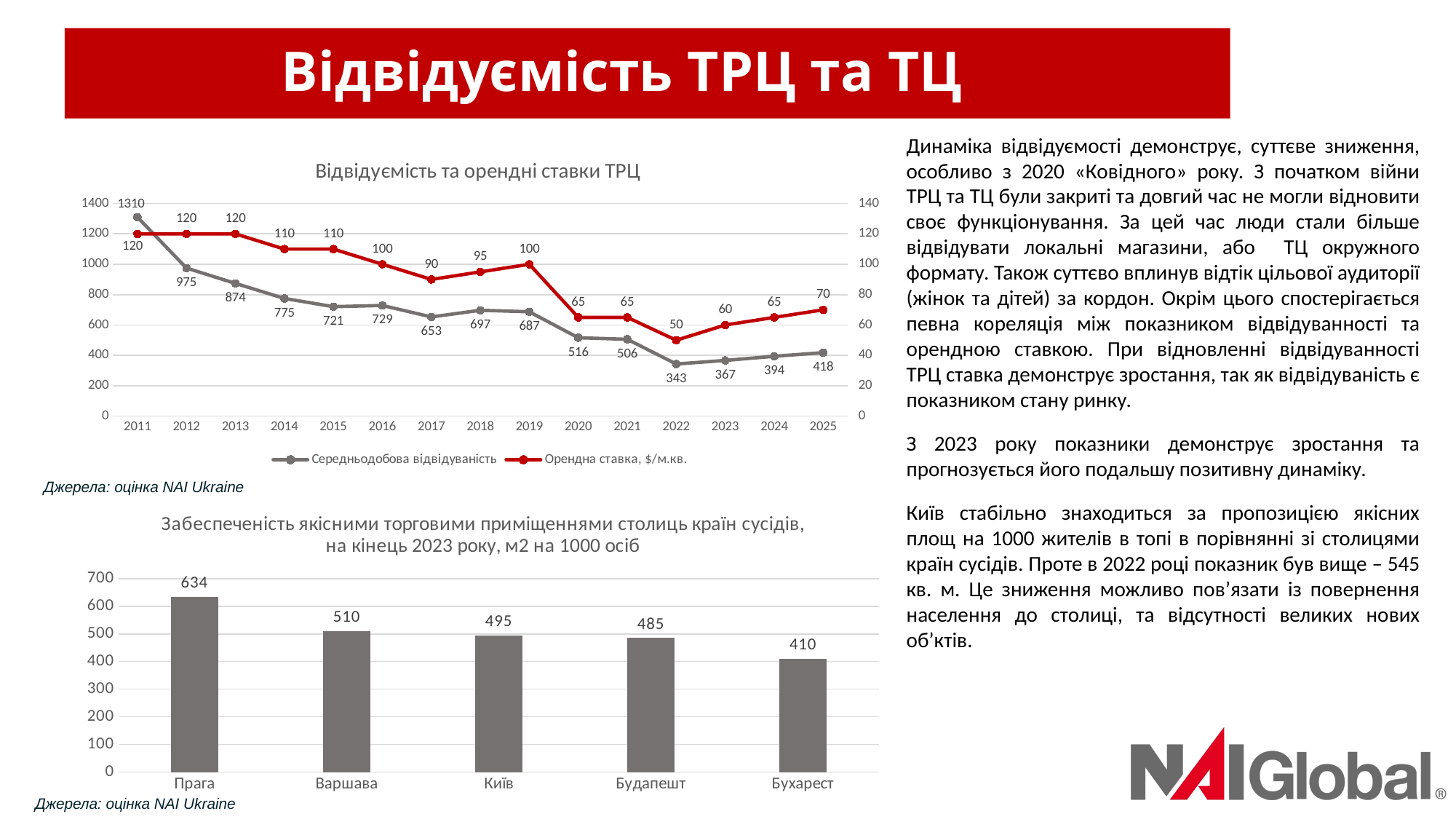
What kind of chart is the bottom chart 'Забезпеченість якісними торговими приміщеннями столиць країн сусідів'? bar chart In the top chart 'Відвідуємість та орендні ставки ТРЦ', what is the Орендна ставка, $/м.кв. in 2022? 50 In the top chart 'Відвідуємість та орендні ставки ТРЦ', what is the difference between Середньодобова відвідуваність in 2011 and in 2012? 335 In the top chart 'Відвідуємість та орендні ставки ТРЦ', does Середньодобова відвідуваність rise or fall from 2011 to 2022? fall In the top chart 'Відвідуємість та орендні ставки ТРЦ', how many series does the legend list? 2 In the top chart 'Відвідуємість та орендні ставки ТРЦ', how many years are shown on the x axis? 15 In the bottom chart 'Забезпеченість якісними торговими приміщеннями столиць країн сусідів', what is the difference between Прага and Варшава? 124 In the top chart 'Відвідуємість та орендні ставки ТРЦ', in which year is Середньодобова відвідуваність lowest? 2022 In the bottom chart 'Забезпеченість якісними торговими приміщеннями столиць країн сусідів', which city has the highest value? Прага In the bottom chart 'Забезпеченість якісними торговими приміщеннями столиць країн сусідів', what is the value for Київ? 495 In the top chart 'Відвідуємість та орендні ставки ТРЦ', what is the value of Середньодобова відвідуваність in 2011? 1310 In the bottom chart 'Забезпеченість якісними торговими приміщеннями столиць країн сусідів', which city has the lowest value? Бухарест